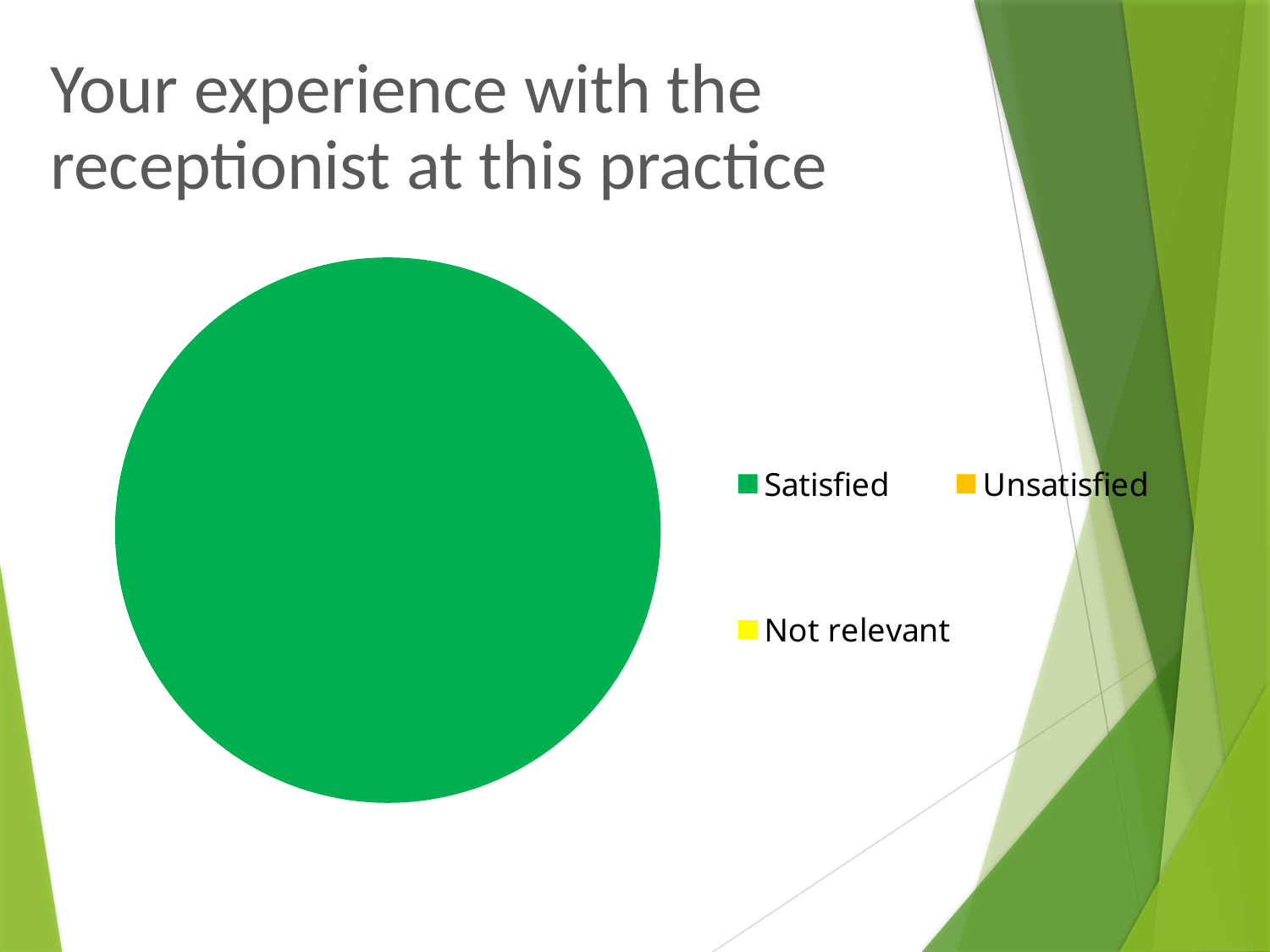
Which legend entries are listed in the pie chart? Satisfied, Unsatisfied, Not relevant Which is larger in the pie chart, Satisfied or Unsatisfied? Satisfied Which category has the largest share of the pie chart? Satisfied How many categories does the legend of the pie chart list? 3 Which category fills essentially the entire pie? Satisfied Which is larger in the pie chart, Satisfied or Not relevant? Satisfied What kind of chart is shown on the slide? Pie chart What is the title of the slide containing the pie chart? Your experience with the receptionist at this practice What colour represents the Satisfied category in the pie chart? Green